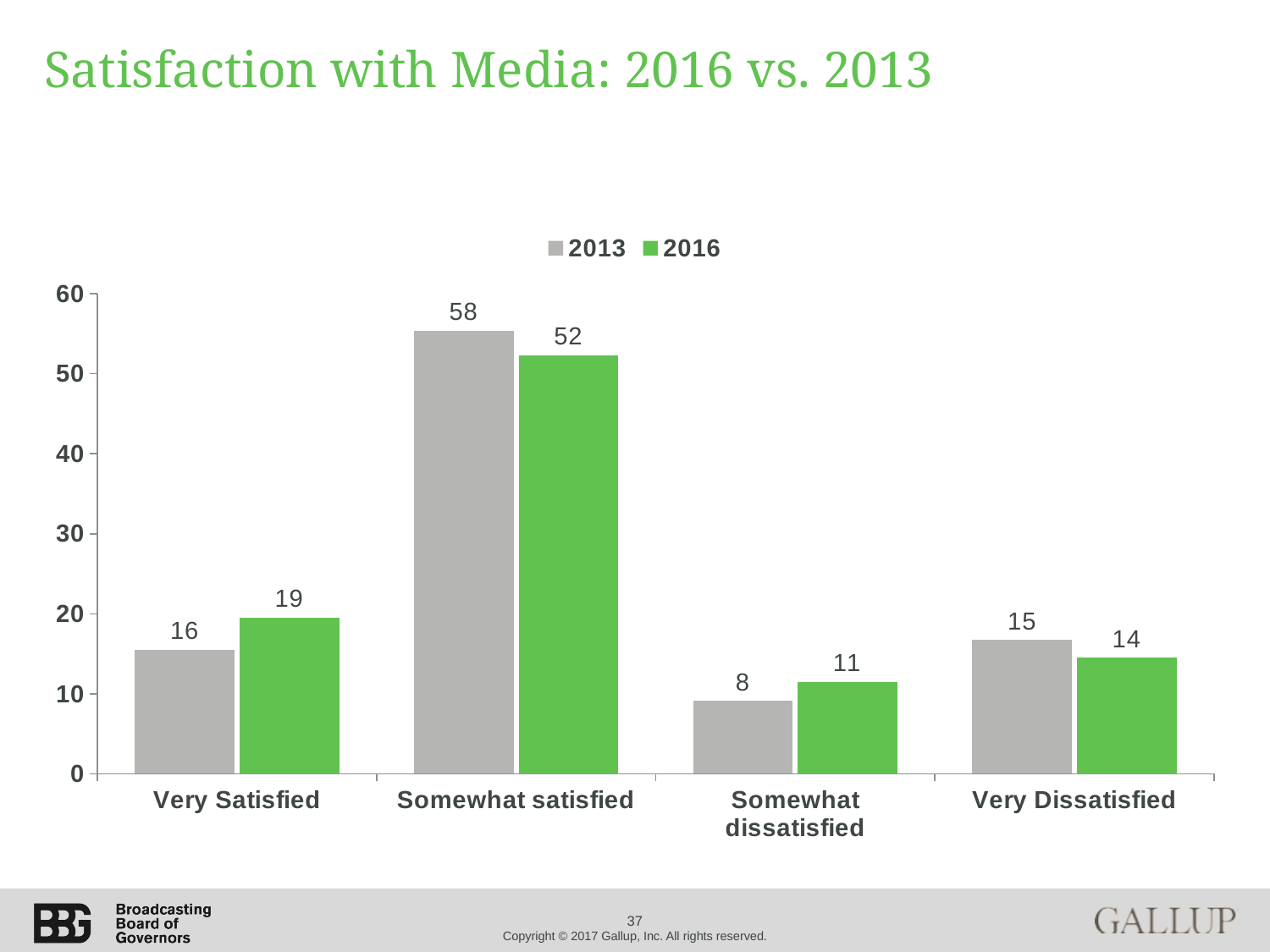
Which is larger for Very Dissatisfied, the 2013 value or the 2016 value? 2013 What kind of chart is shown on the slide? Bar chart How many categories are shown on the x axis? 4 What is the 2016 value for Somewhat dissatisfied? 11 Is the 2013 value for Somewhat satisfied greater or less than 50? greater What is the 2013 value for Somewhat satisfied? 58 How many series does the legend list? 2 What is the 2016 value for Very Satisfied? 19 Which category has the highest 2016 value? Somewhat satisfied What is the difference between the 2013 and 2016 values for Somewhat satisfied? 6 Which category has the lowest 2013 value? Somewhat dissatisfied Which colour represents the 2016 series? Green